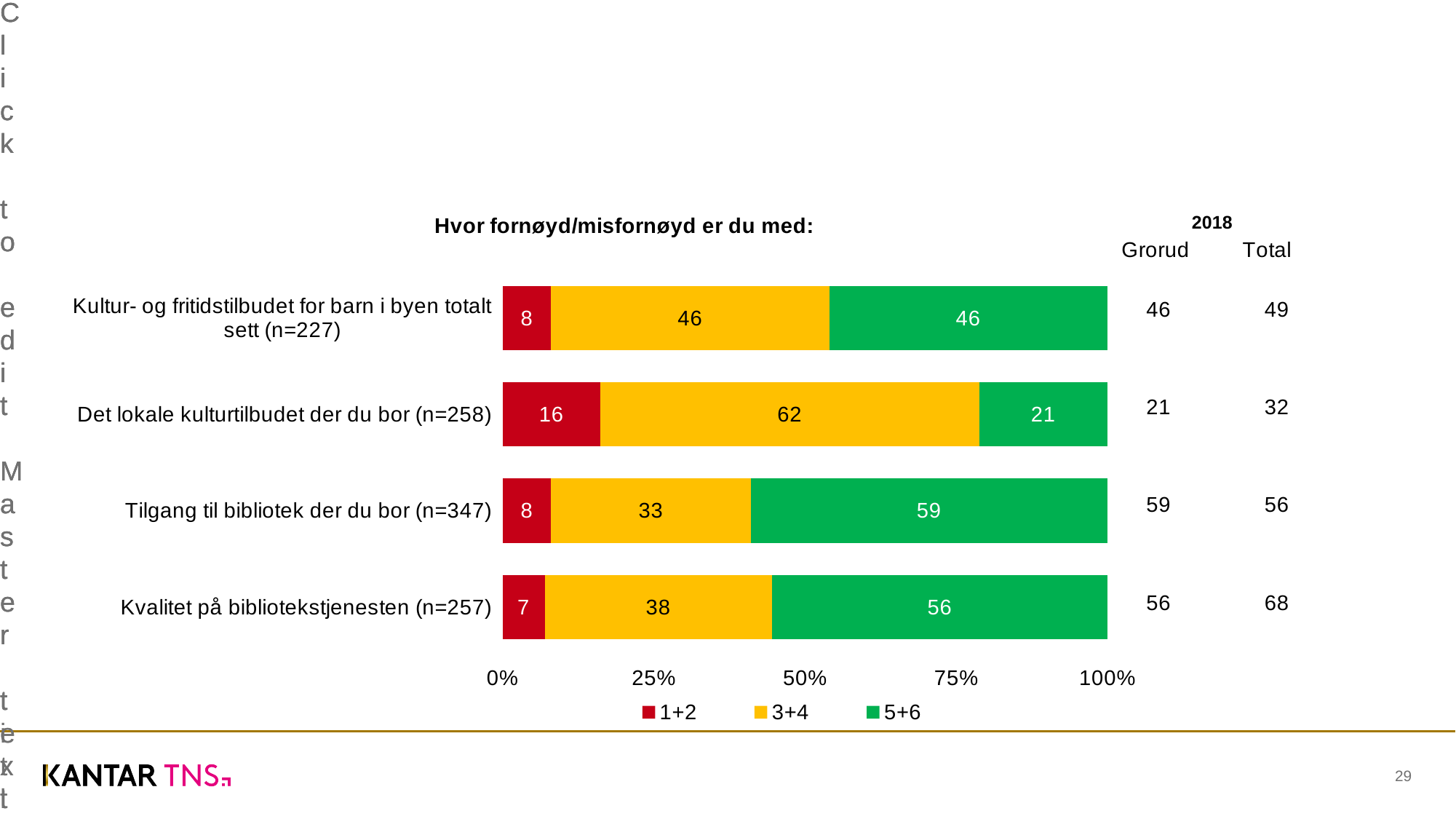
What is the value of the 3+4 series for "Kvalitet på bibliotekstjenesten (n=257)"? 38 How many series does the legend list? 3 How many categories are plotted in the chart? 4 Which category has the highest value for the 3+4 series? Det lokale kulturtilbudet der du bor (n=258) What is the total of the stacked bar for "Kultur- og fritidstilbudet for barn i byen totalt sett (n=227)"? 100 Which category has the lowest value for the 5+6 series? Det lokale kulturtilbudet der du bor (n=258) What is the value of the 5+6 series for "Tilgang til bibliotek der du bor (n=347)"? 59 What is the title of the chart? Hvor fornøyd/misfornøyd er du med: Which is larger: the 1+2 value for "Det lokale kulturtilbudet der du bor (n=258)" or the 1+2 value for "Kvalitet på bibliotekstjenesten (n=257)"? Det lokale kulturtilbudet der du bor (n=258) What kind of chart is shown on the slide? Stacked bar chart What is the difference between the 5+6 values for "Tilgang til bibliotek der du bor (n=347)" and "Det lokale kulturtilbudet der du bor (n=258)"? 38 What is the value of the 1+2 series for "Det lokale kulturtilbudet der du bor (n=258)"? 16